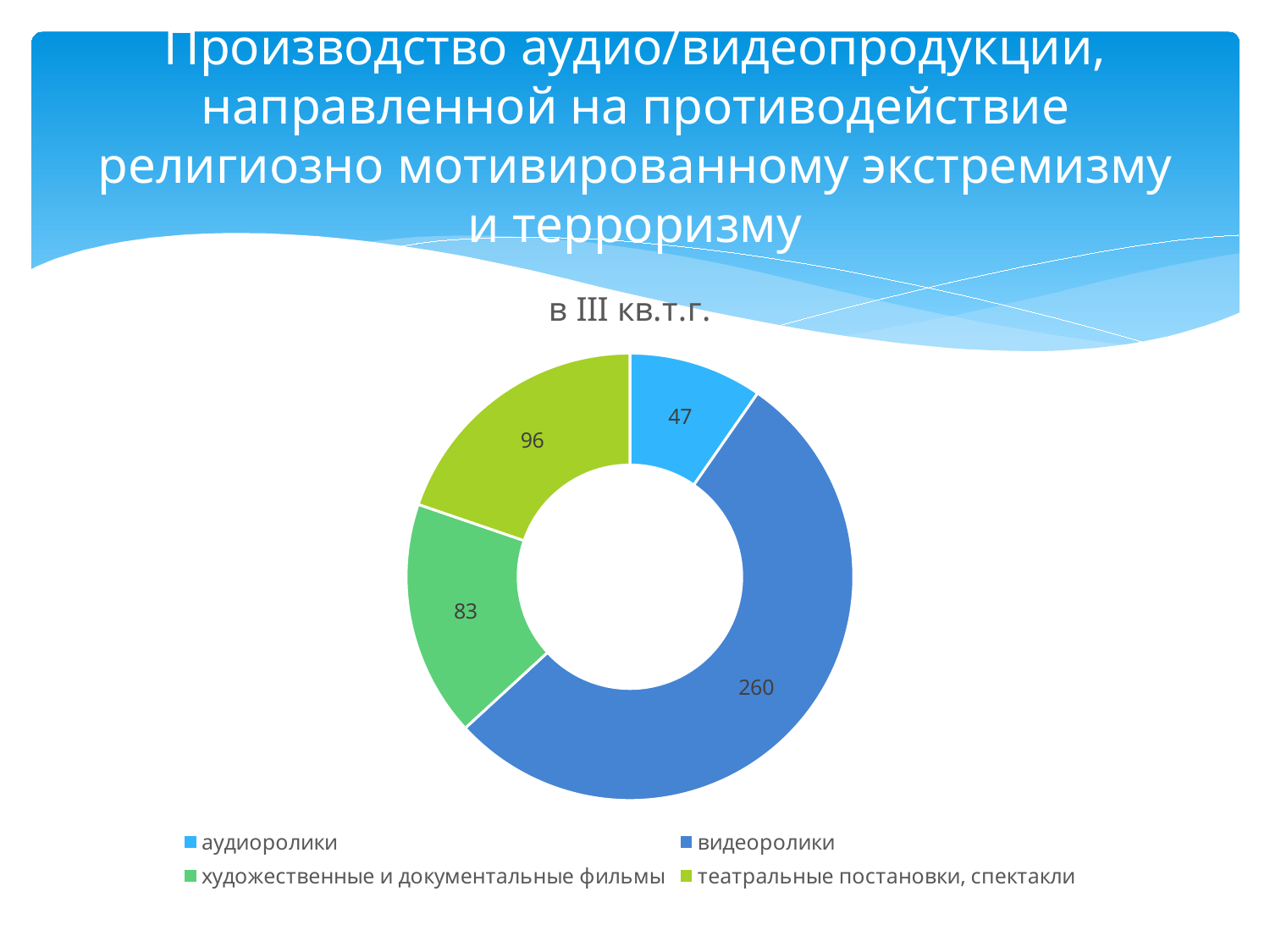
What is the value for театральные постановки, спектакли? 96 Which category has the lowest value? аудиоролики What is the value for художественные и документальные фильмы? 83 Which category has the highest value? видеоролики What is the total of all the values shown in the chart? 486 What is the difference between the values for видеоролики and театральные постановки, спектакли? 164 What kind of chart is shown on the slide? doughnut chart Which is larger, the value for театральные постановки, спектакли or the value for художественные и документальные фильмы? театральные постановки, спектакли What is the title of the chart? в III кв.т.г. What is the value for видеоролики? 260 How many categories does the chart show? 4 What is the value for аудиоролики? 47